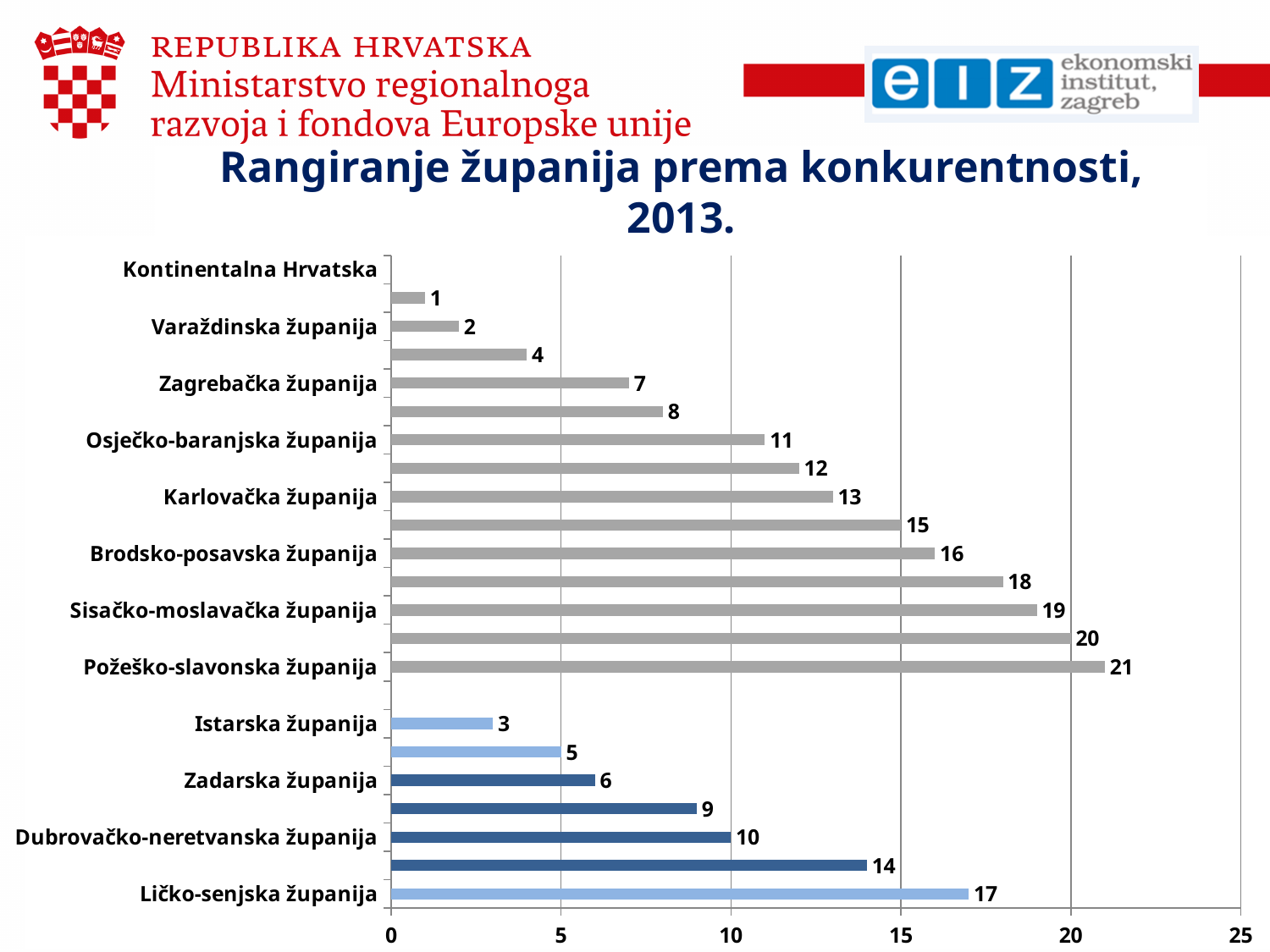
What is the value for Ličko-senjska županija? 17 Which has a larger value, Karlovačka županija or Zadarska županija? Karlovačka županija What is the title of the chart? Rangiranje županija prema konkurentnosti, 2013. What is the value for Istarska županija? 3 What is the value for Varaždinska županija? 2 How many bars are plotted on the chart? 21 Which labeled county has the highest value on the chart? Požeško-slavonska županija Is the value for Ličko-senjska županija greater or less than 15? greater What is the value for Požeško-slavonska županija? 21 What kind of chart is shown on the slide? bar chart What is the value for Dubrovačko-neretvanska županija? 10 What is the difference between the values for Požeško-slavonska županija and Istarska županija? 18